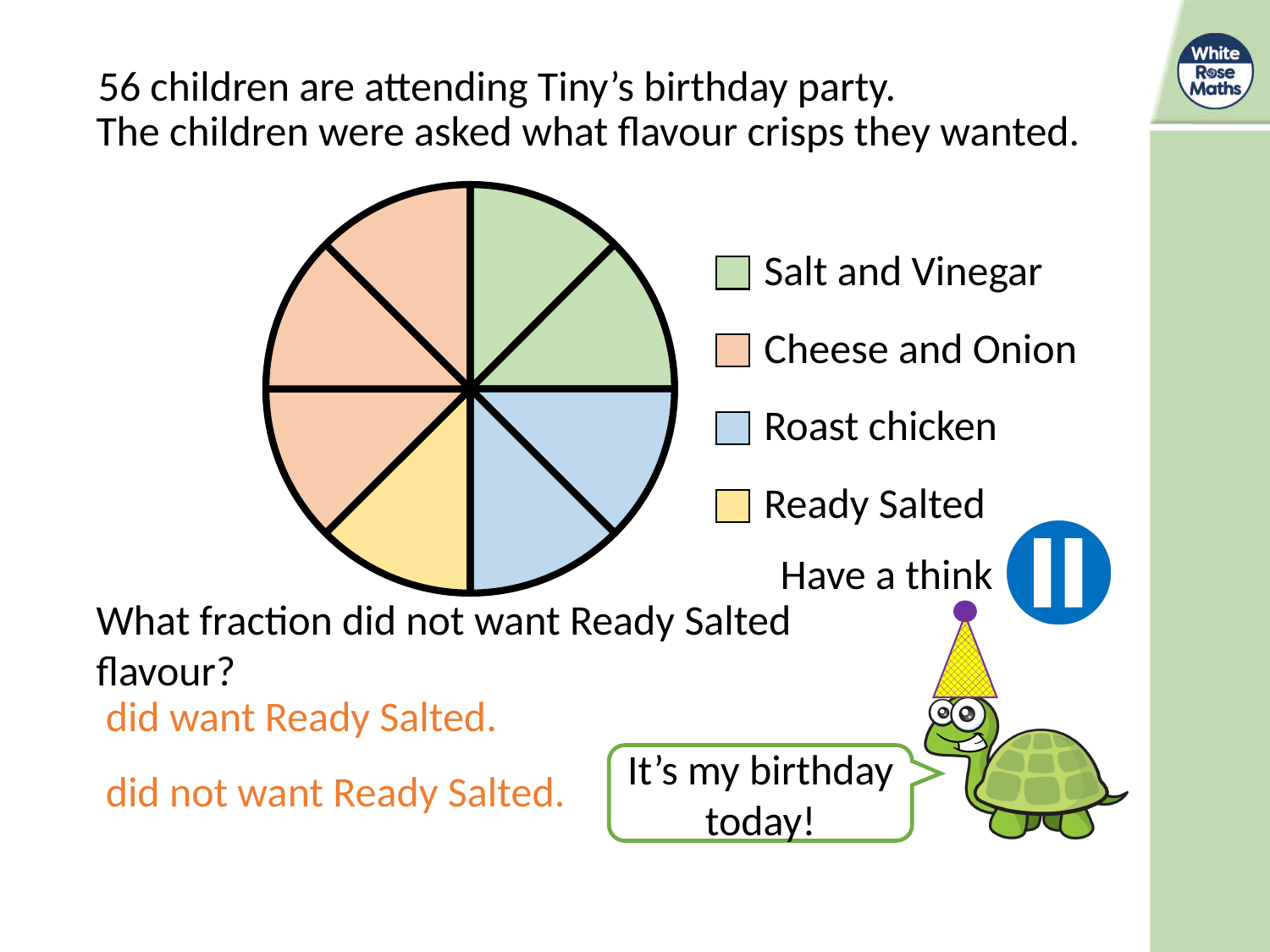
Which flavour takes up the largest share of the pie chart? Cheese and Onion Which has the larger share of the pie chart, Cheese and Onion or Roast chicken? Cheese and Onion What kind of chart is shown on the slide? pie chart What fraction of the pie chart is Cheese and Onion? 3/8 What fraction of the pie chart is Ready Salted? 1/8 Into how many equal sectors is the pie chart divided? 8 How many crisp flavours does the legend list? 4 Which flavour takes up the smallest share of the pie chart? Ready Salted What fraction of the pie chart is not Ready Salted? 7/8 Which has the larger share of the pie chart, Salt and Vinegar or Ready Salted? Salt and Vinegar What colour represents Roast chicken in the pie chart? blue Which flavour is shown in green in the pie chart? Salt and Vinegar